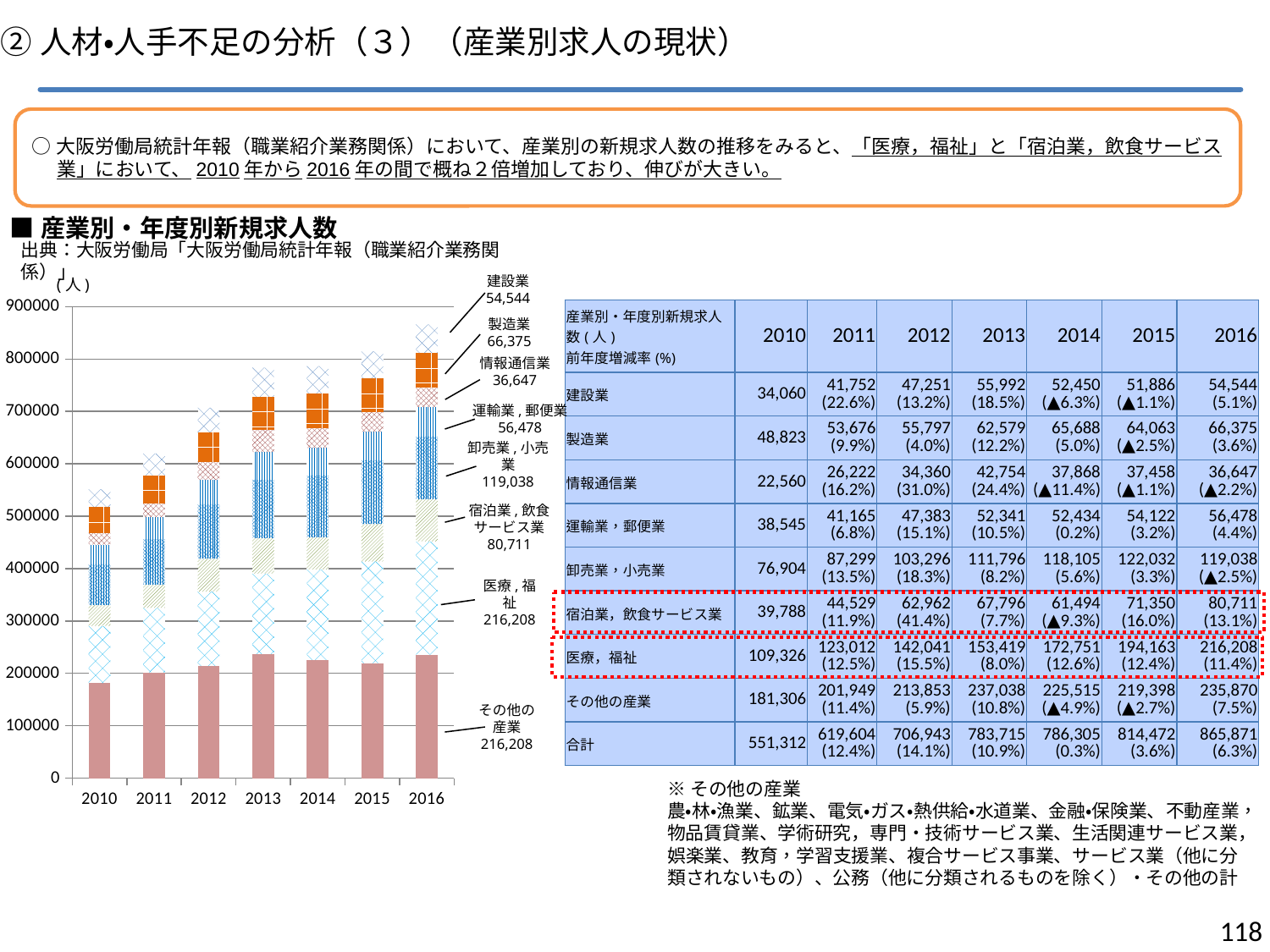
What kind of chart is shown on the slide? Stacked bar chart What is the difference between the 2016 values for 医療，福祉 and 宿泊業，飲食サービス業 shown on the chart? 135,497 Do the total heights of the stacked bars generally rise or fall from 2010 to 2016? Rise Which year has the shortest stacked bar in the chart? 2010 In 2016, which is larger on the chart: 製造業 or 建設業? 製造業 How many industry segments are labelled in the stacked bars of the chart? 8 Which year has the tallest stacked bar in the chart? 2016 What is the value labelled for 卸売業，小売業 in 2016 on the chart? 119,038 What is the value labelled for 宿泊業，飲食サービス業 in 2016 on the chart? 80,711 What is the value labelled for 医療，福祉 in 2016 on the chart? 216,208 How many years are shown on the x axis of the chart? 7 Is the total height of the 2013 stacked bar greater or less than 700000? greater